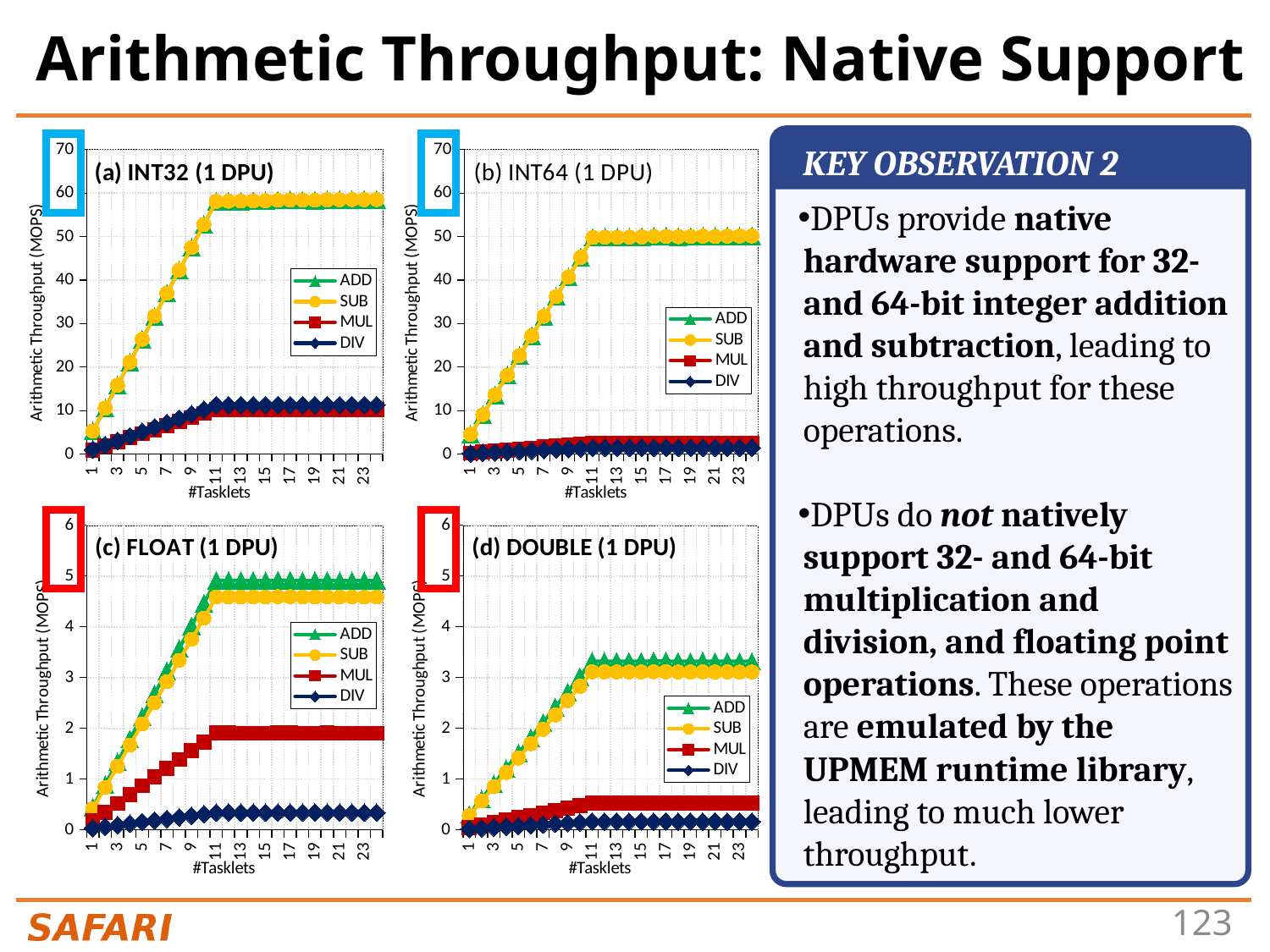
In chart (a) INT32 (1 DPU), is the value for ADD at 23 tasklets greater or less than 50? greater In chart (b) INT64 (1 DPU), is the value for MUL at 23 tasklets greater or less than 10? less In chart (a) INT32 (1 DPU), does the ADD series rise or fall as #Tasklets goes from 1 to 11? rise How many series does the legend of chart (c) FLOAT (1 DPU) list? 4 How many charts are shown on the slide? 4 In chart (c) FLOAT (1 DPU), is the value for ADD at 23 tasklets greater or less than 4? greater What is the label of the x axis in chart (b) INT64 (1 DPU)? #Tasklets In chart (d) DOUBLE (1 DPU), which is larger at 23 tasklets, ADD or DIV? ADD What kind of chart is chart (a) INT32 (1 DPU)? line chart In chart (c) FLOAT (1 DPU), which series has the highest throughput at 23 tasklets? ADD In chart (c) FLOAT (1 DPU), which series has the lowest throughput at 23 tasklets? DIV